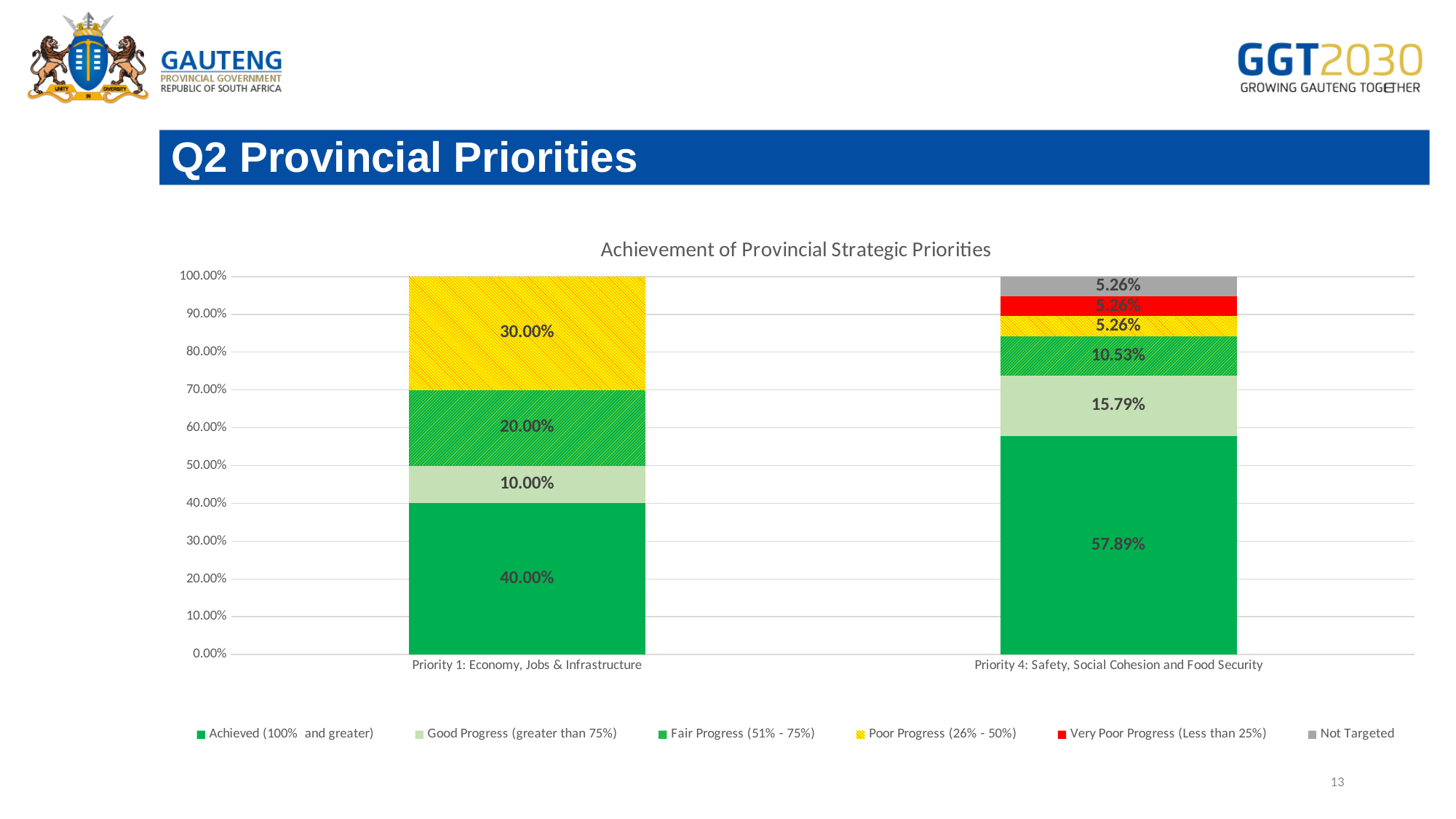
What is the Good Progress (greater than 75%) value for Priority 4: Safety, Social Cohesion and Food Security? 15.79% What is the Achieved (100% and greater) value for Priority 1: Economy, Jobs & Infrastructure? 40.00% What is the Not Targeted value for Priority 4: Safety, Social Cohesion and Food Security? 5.26% What is the Achieved (100% and greater) value for Priority 4: Safety, Social Cohesion and Food Security? 57.89% What is the title of the chart? Achievement of Provincial Strategic Priorities What kind of chart is shown on the slide? Stacked bar chart What is the difference between the Achieved values for Priority 4 and Priority 1? 17.89% Which segment is the largest in the Priority 1: Economy, Jobs & Infrastructure bar? Achieved (100% and greater) What is the Poor Progress (26% - 50%) value for Priority 1: Economy, Jobs & Infrastructure? 30.00% How many priorities (categories) are plotted on the x axis? 2 How many series does the legend list? 6 Which priority has the higher Achieved (100% and greater) share, Priority 1 or Priority 4? Priority 4: Safety, Social Cohesion and Food Security